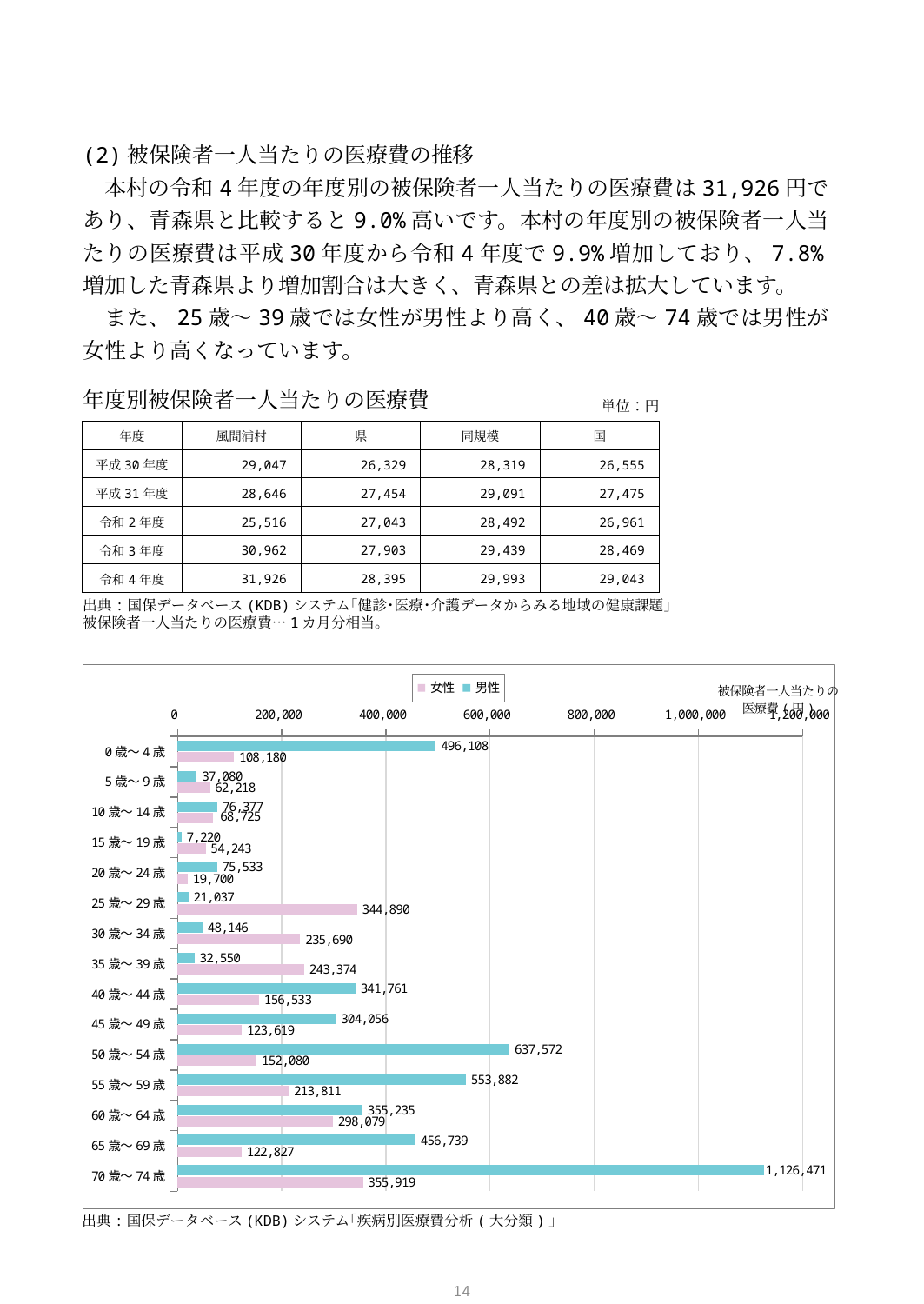
Which colour represents the 女性 series in the chart? pink What type of chart is shown on the slide? bar chart How many series does the chart legend list? 2 How many age-group categories are plotted in the chart? 15 Which age group has the lowest 女性 value? 20歳～24歳 What is the value for 女性 in the 25歳～29歳 category? 344,890 Is the 男性 value for 55歳～59歳 greater or less than 400,000? greater What is the difference between the 男性 and 女性 values in the 50歳～54歳 category? 485,492 What is the value for 男性 in the 15歳～19歳 category? 7,220 What is the value for 男性 in the 70歳～74歳 category? 1,126,471 Which age group has the highest 男性 value? 70歳～74歳 In the 35歳～39歳 category, which is larger, the 女性 value or the 男性 value? 女性